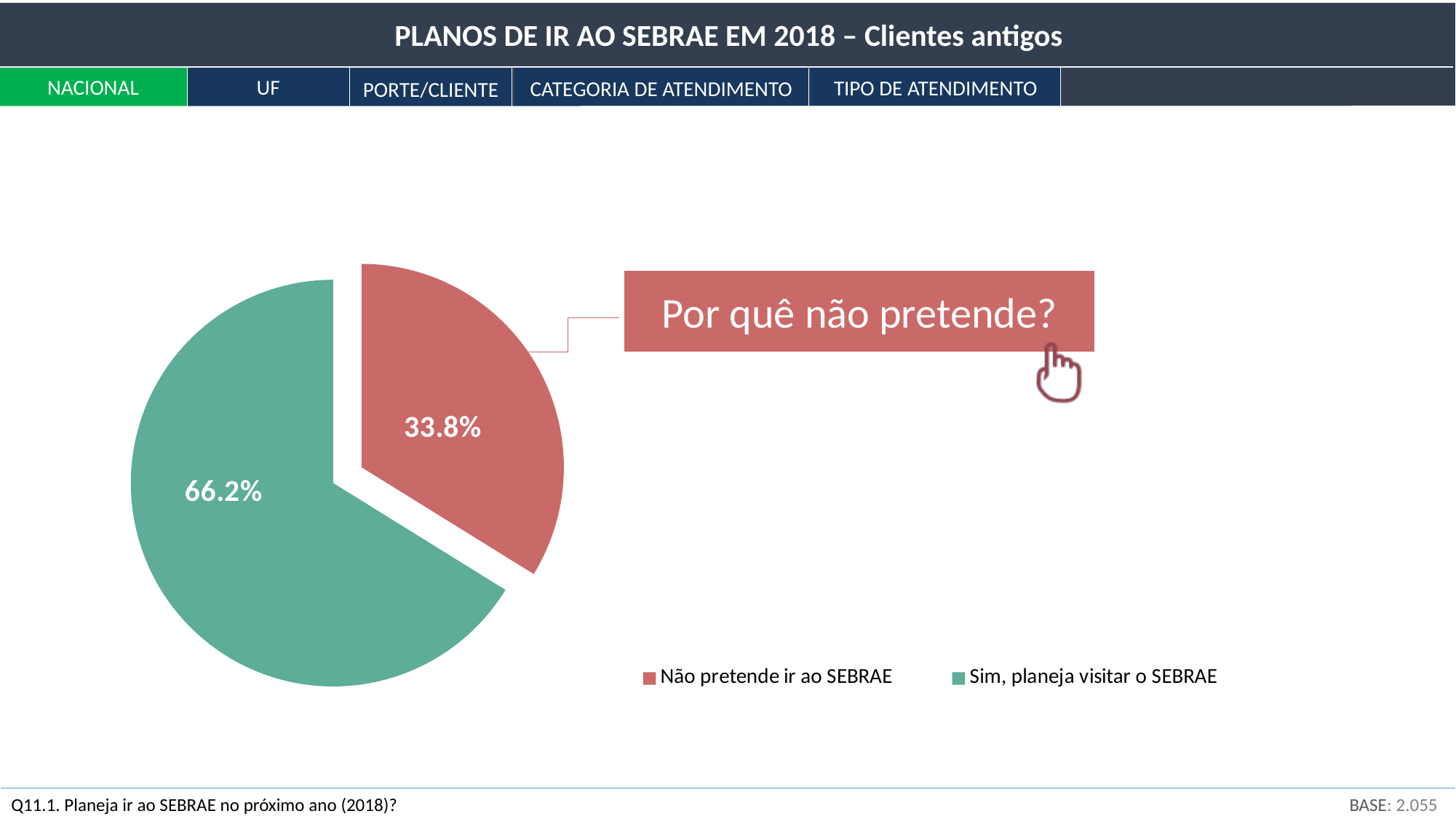
Which slice of the pie is the smallest? Não pretende ir ao SEBRAE Which slice of the pie is the largest? Sim, planeja visitar o SEBRAE How many entries does the legend list? 2 What colour is the 'Não pretende ir ao SEBRAE' slice? red What is the base (number of respondents) shown on the slide? 2.055 What kind of chart is shown on the slide? pie chart What share of the pie is 'Sim, planeja visitar o SEBRAE'? 66.2% Which is larger: 'Não pretende ir ao SEBRAE' or 'Sim, planeja visitar o SEBRAE'? Sim, planeja visitar o SEBRAE What share of the pie is 'Não pretende ir ao SEBRAE'? 33.8% How many slices does the pie chart have? 2 What is the difference in percentage points between 'Sim, planeja visitar o SEBRAE' and 'Não pretende ir ao SEBRAE'? 32.4